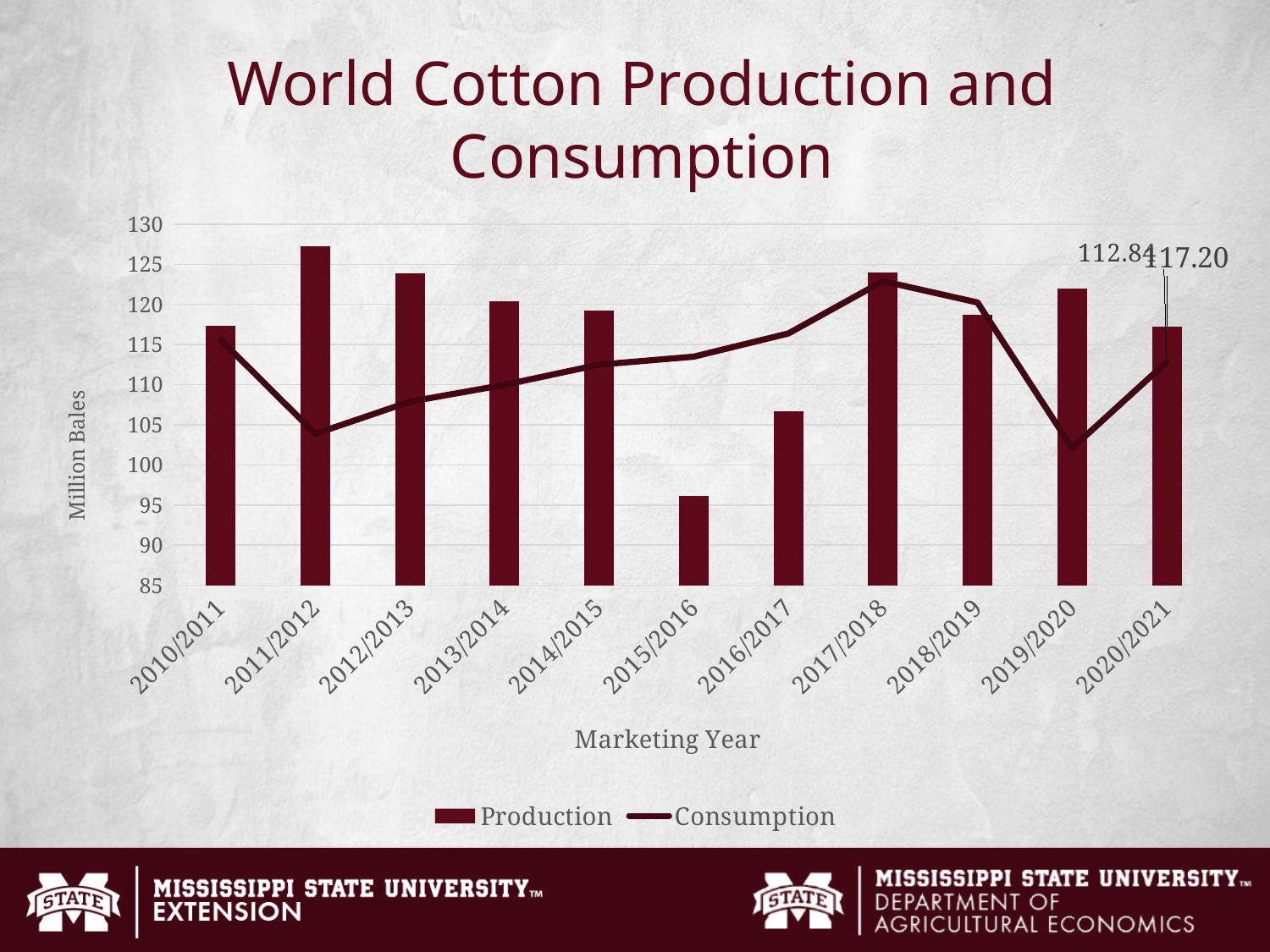
Is the Production value for 2015/2016 greater or less than 100? less What kind of chart is shown on the slide? A bar chart combined with a line chart What is the label on the vertical axis? Million Bales How many series does the legend list? 2 How many marketing years are shown on the x axis? 11 Is the Production value for 2011/2012 greater or less than 125? greater What is the Production value for 2020/2021? 117.20 Which marketing year has the lowest Production? 2015/2016 Which is larger, Production in 2016/2017 or Production in 2017/2018? 2017/2018 Which marketing year has the highest Production? 2011/2012 What is the difference between Production and Consumption in 2020/2021? 4.36 What is the Consumption value for 2020/2021? 112.84